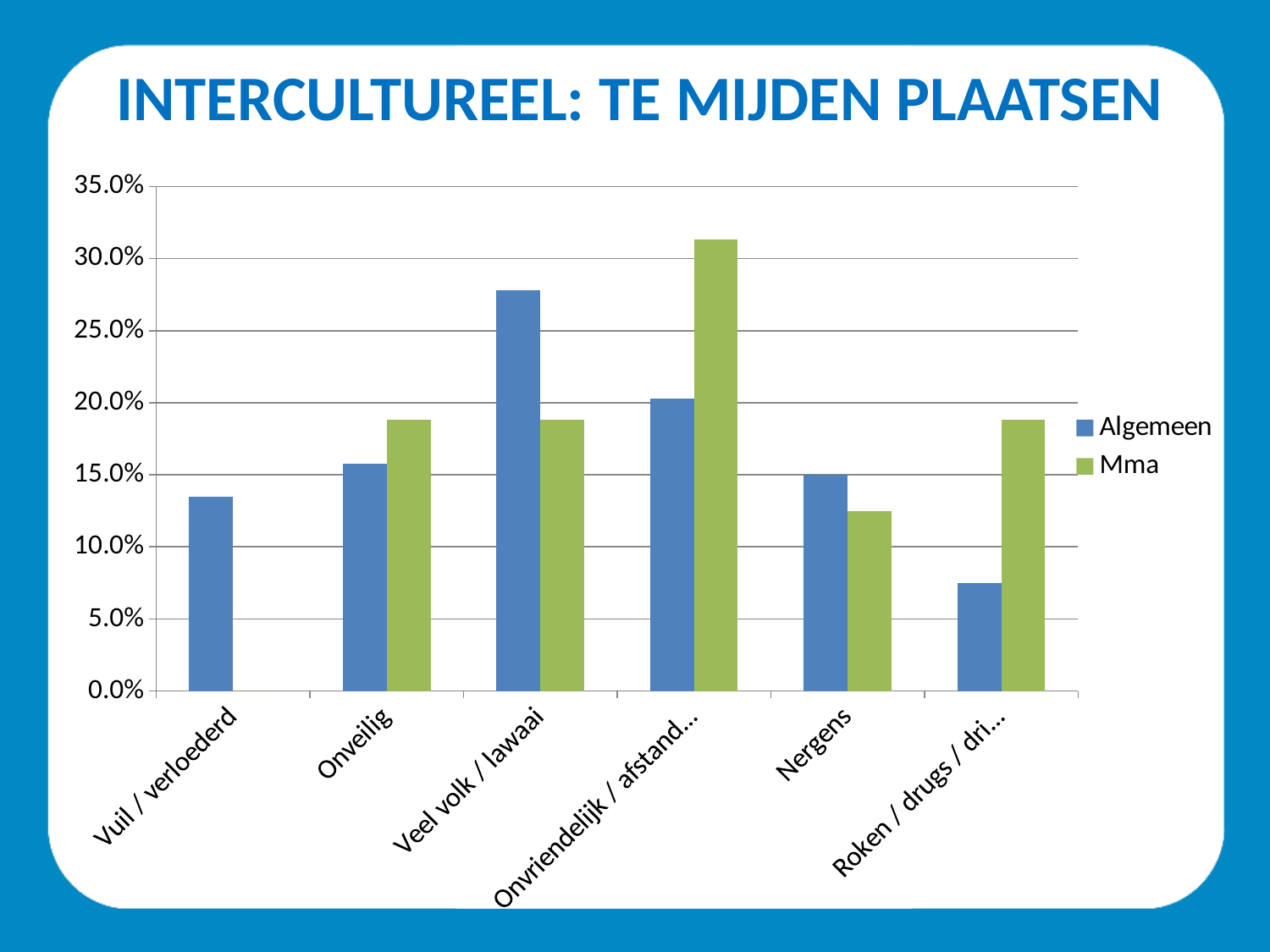
Which category has the highest value for the Algemeen series? Veel volk / lawaai What type of chart is shown on the slide? bar chart Is the Algemeen value for Veel volk / lawaai greater or less than 25.0%? greater Which series is shown in green in the legend? Mma Which category has the lowest value for the Algemeen series? Roken / drugs / dri... For Onveilig, which series has the larger value, Algemeen or Mma? Mma Is the Algemeen value for Roken / drugs / dri... greater or less than 10.0%? less Is the Mma value for Onvriendelijk / afstand... greater or less than 30.0%? greater How many categories are shown on the x axis? 6 Which category has the highest value for the Mma series? Onvriendelijk / afstand... How many series does the legend list? 2